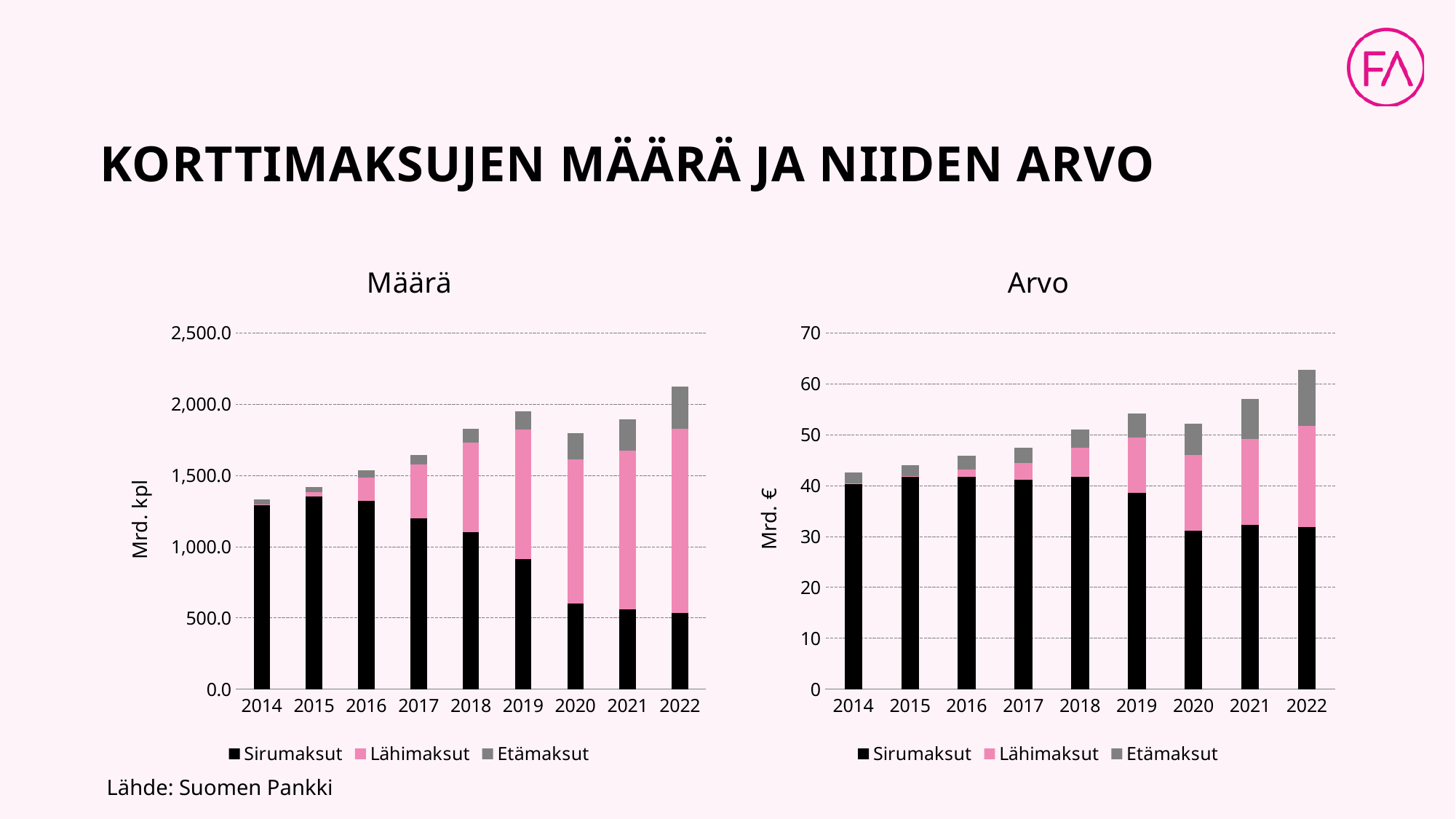
In the Arvo chart, is the total bar for 2022 greater or less than 60? greater In the Arvo chart, which year has the highest total bar? 2022 In the Arvo chart, is the total bar for 2021 larger or smaller than the total bar for 2020? larger In the Määrä chart, is the Sirumaksut value for 2019 greater or less than 1,000.0? less In the Määrä chart, does the Sirumaksut series rise or fall from 2016 to 2022? fall In the Määrä chart, which year has the lowest total bar? 2014 What kind of chart is the Määrä chart? Stacked bar chart In the Määrä chart, is the total bar for 2014 greater or less than 1,500.0? less How many series does the legend of the Arvo chart list? 3 How many years are shown on the x axis of the Määrä chart? 9